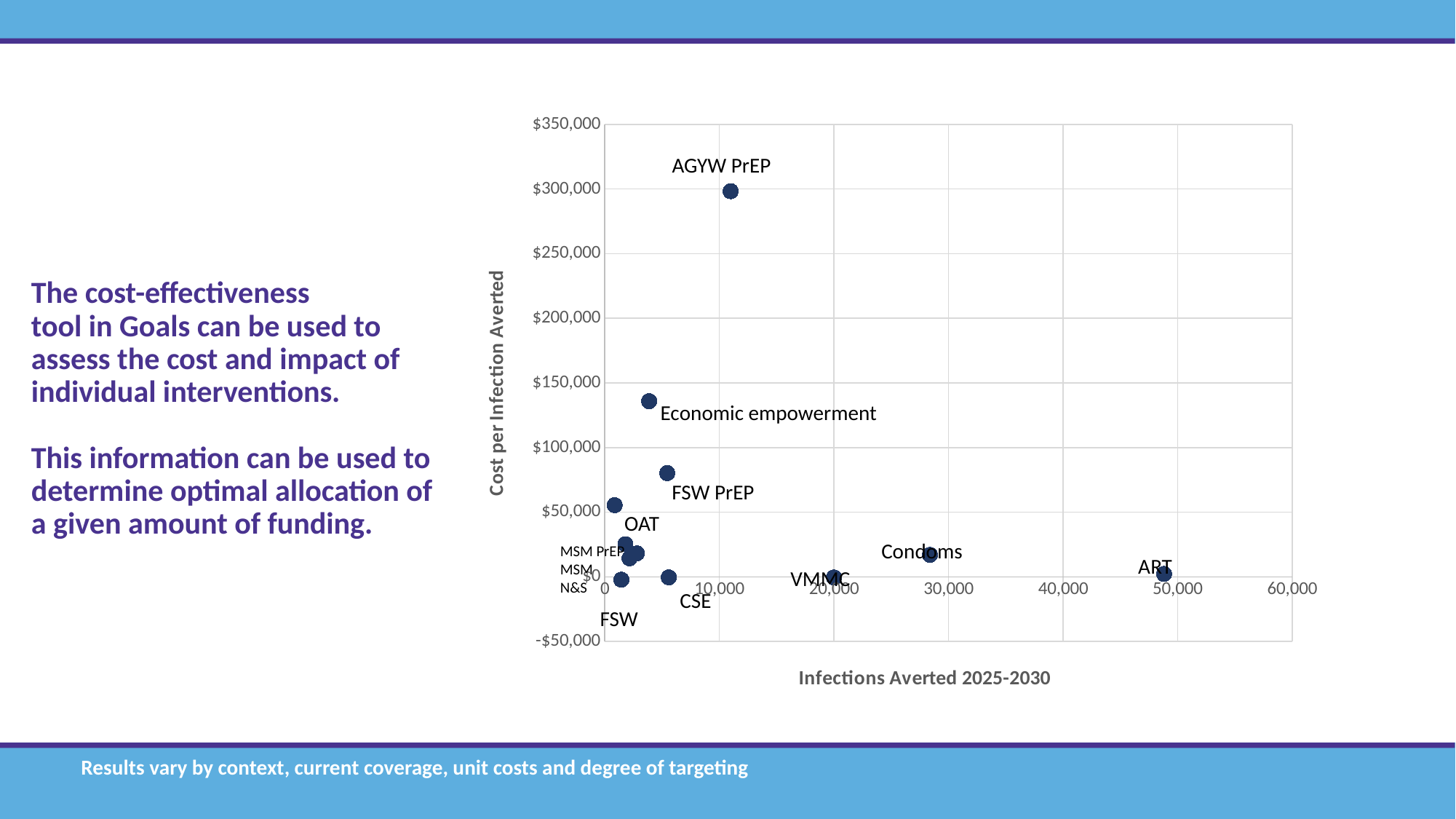
What is the title of the horizontal axis? Infections Averted 2025-2030 Which averts more infections, ART or Condoms? ART What kind of chart is shown on the slide? Scatter chart How many interventions are plotted on the chart? 12 Is the cost per infection averted for AGYW PrEP greater or less than $250,000? greater Is the cost per infection averted for Economic empowerment greater or less than $150,000? less Which intervention averts the most infections in 2025-2030? ART Is the number of infections averted by ART greater or less than 40,000? greater Which has a higher cost per infection averted, AGYW PrEP or Economic empowerment? AGYW PrEP Which intervention has the highest cost per infection averted? AGYW PrEP